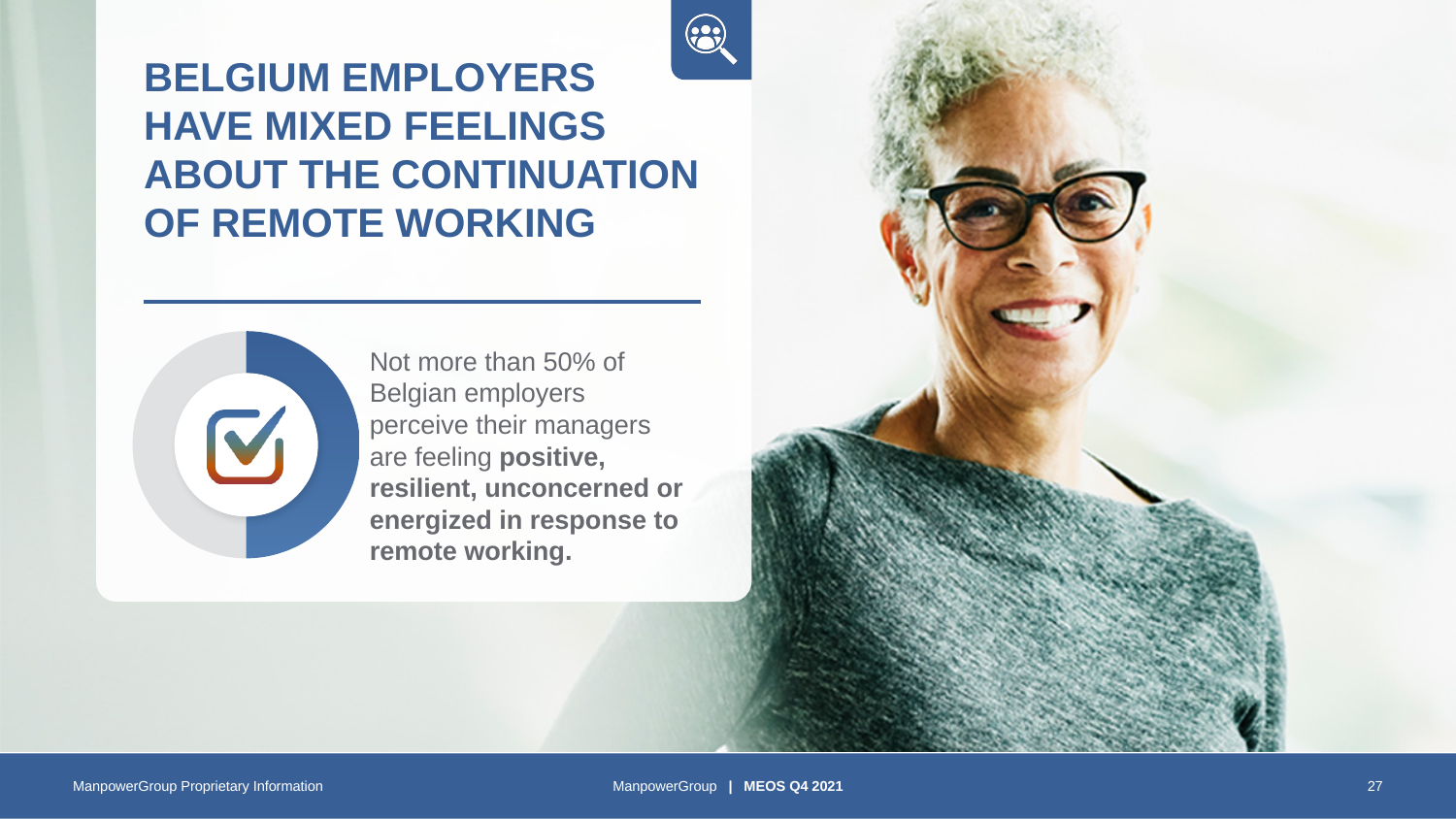
According to the slide, what share of Belgian employers perceive their managers as feeling positive, resilient, unconcerned or energized in response to remote working? Not more than 50% What colour is the filled segment of the donut chart? Blue What icon appears in the centre of the donut chart? A checkmark What percentage is stated in the text accompanying the donut chart? 50% How many segments does the donut chart have? 2 What kind of chart is shown on the left of the slide next to the text about Belgian employers? Donut (pie) chart